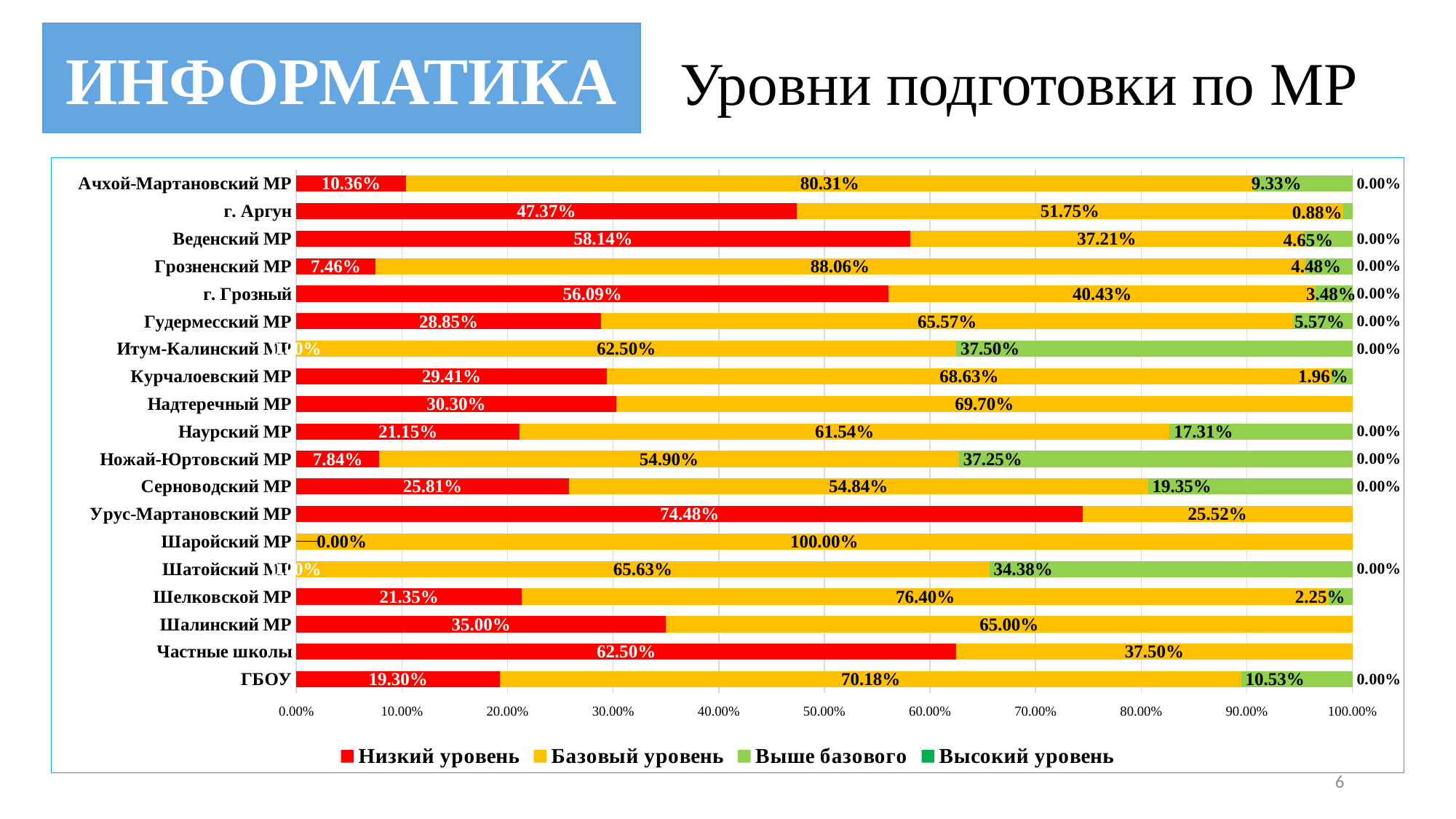
Which category has the highest value for Базовый уровень? Шаройский МР How many series does the legend list? 4 How many categories (rows) are plotted in the chart? 19 What type of chart is shown on the slide? Stacked bar chart What is the value of Базовый уровень for Шаройский МР? 100.00% Which category has the highest value for Низкий уровень? Урус-Мартановский МР Which is larger: Низкий уровень for Частные школы or Низкий уровень for Шалинский МР? Частные школы What is the value of Выше базового for Наурский МР? 17.31% What is the value of Низкий уровень for Урус-Мартановский МР? 74.48% Which series is shown in red in the legend? Низкий уровень What is the value of Базовый уровень for Грозненский МР? 88.06% What is the difference between Базовый уровень and Низкий уровень for Ачхой-Мартановский МР? 69.95%